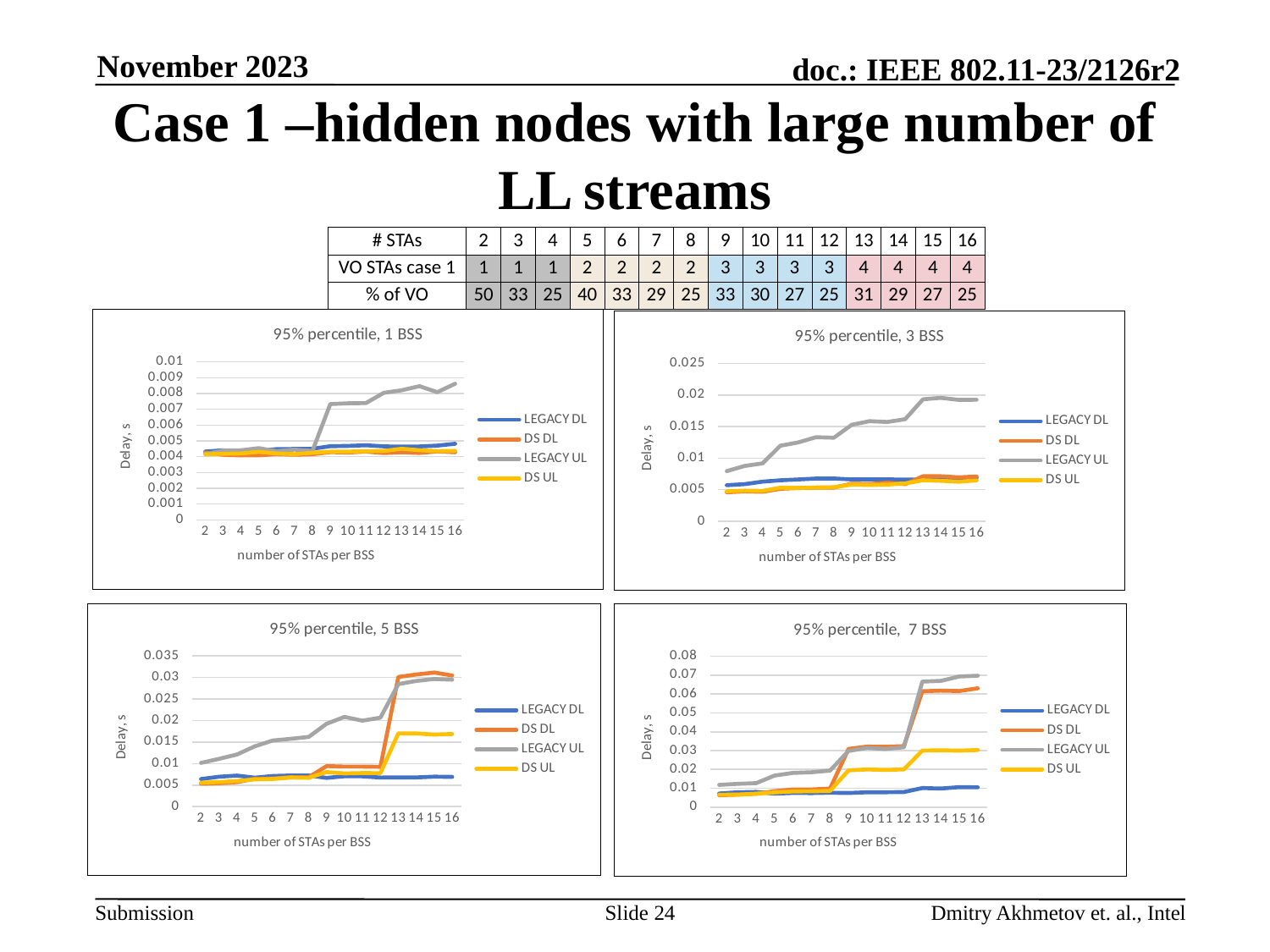
How many series does the legend of the "95% percentile, 3 BSS" chart list? 4 In the "95% percentile, 1 BSS" chart, is the LEGACY UL value at 16 STAs greater or less than 0.008? greater In the "95% percentile, 3 BSS" chart, does the LEGACY UL series generally rise or fall as the number of STAs per BSS increases? rise In the "95% percentile, 1 BSS" chart, which series has the highest value at 16 STAs? LEGACY UL In the "95% percentile, 5 BSS" chart, is the DS DL value at 16 STAs greater or less than 0.025? greater In the "95% percentile, 7 BSS" chart, is the LEGACY DL value at 16 STAs greater or less than 0.02? less How many x-axis points (number of STAs per BSS) are plotted in the "95% percentile, 5 BSS" chart? 15 In the "95% percentile, 5 BSS" chart, which is larger at 16 STAs: DS UL or LEGACY DL? DS UL What kind of chart is the "95% percentile, 1 BSS" chart? line chart What is the y-axis title of the "95% percentile, 7 BSS" chart? Delay, s In the "95% percentile, 7 BSS" chart, which series has the highest value at 16 STAs? LEGACY UL